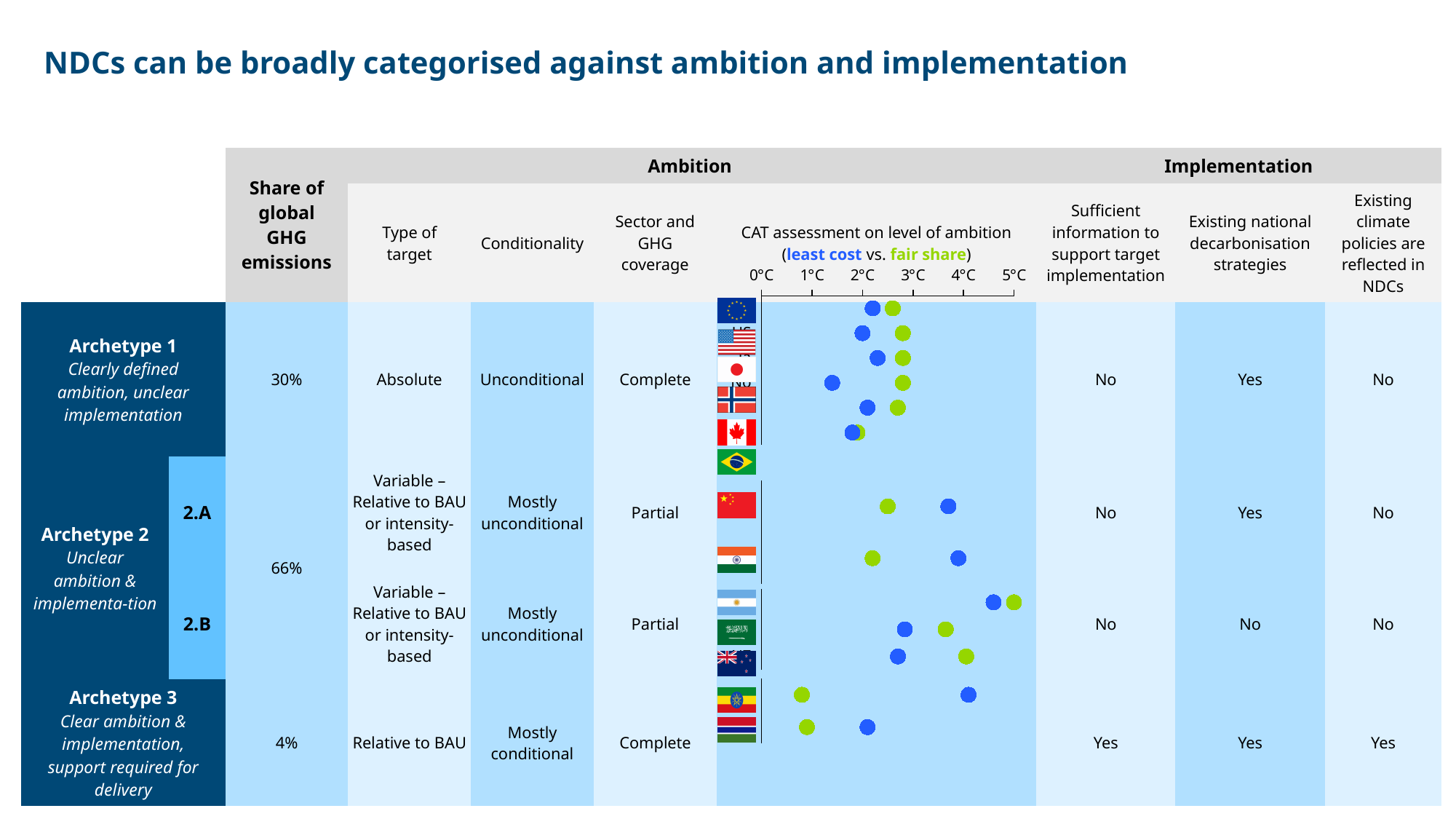
In the 'CAT assessment on level of ambition' chart, for the row with the China flag, which is higher: the least cost value or the fair share value? Least cost In the 'CAT assessment on level of ambition' chart, is the least cost (blue) value for the row with the China flag greater or less than 3°C? greater In the 'CAT assessment on level of ambition' chart, is the least cost (blue) value for the row with the Ethiopia flag greater or less than 3°C? greater In the 'CAT assessment on level of ambition' chart, is the fair share (green) value for the row with the India flag greater or less than 3°C? less How many series does the 'CAT assessment on level of ambition' chart show? 2 In the 'CAT assessment on level of ambition' chart, for the row with the Argentina flag, which is higher: the least cost value or the fair share value? Fair share What kind of chart is the 'CAT assessment on level of ambition' chart? Dot plot (scatter chart) In the 'CAT assessment on level of ambition' chart, what colour represents 'least cost'? Blue What is the highest tick label on the axis of the 'CAT assessment on level of ambition' chart? 5°C In the 'CAT assessment on level of ambition' chart, which row has the highest least cost (blue) value? The row with the Argentina flag